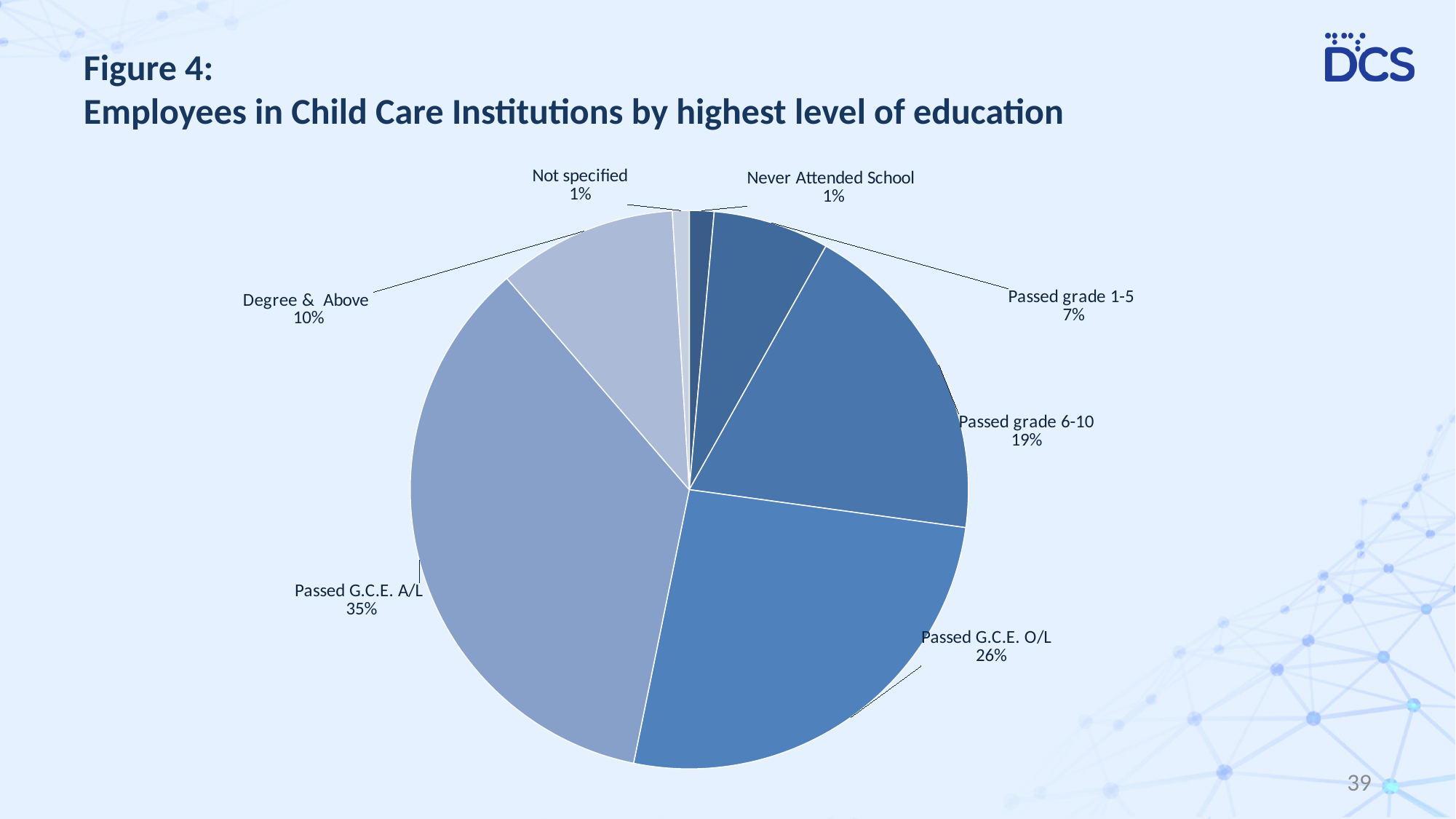
What kind of chart is shown on the slide? pie chart What share of employees have Passed grade 6-10? 19% What share of employees have Passed G.C.E. O/L? 26% Which is larger: the share for Passed grade 6-10 or the share for Degree & Above? Passed grade 6-10 What share of employees have a Degree & Above? 10% How many categories are shown in the pie chart? 7 Which education level has the largest share of employees? Passed G.C.E. A/L What is the title of the chart? Employees in Child Care Institutions by highest level of education What is the difference in percentage points between Passed G.C.E. A/L and Passed G.C.E. O/L? 9 percentage points